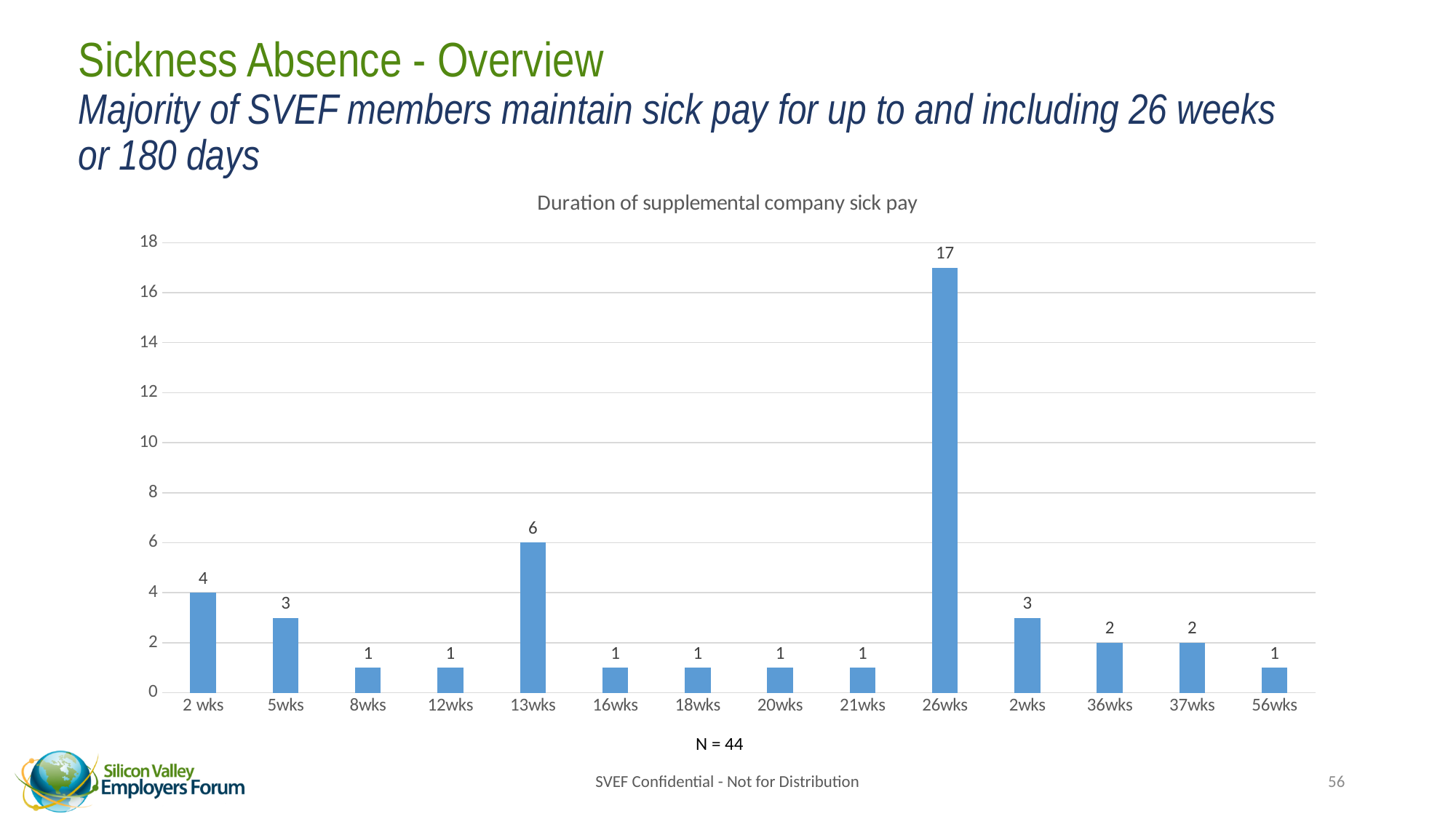
Which category has the highest value? 26wks Which is larger, the value for 13wks or the value for 5wks? 13wks What is the value for 36wks? 2 What kind of chart is this? bar chart What is the difference between the values for 26wks and 13wks? 11 What is the value for 13wks? 6 What is the value for 5wks? 3 What is the value for 26wks? 17 How many categories are shown on the x axis? 14 Is the value for 26wks greater or less than 16? greater What is the value for 56wks? 1 What is the title of the chart? Duration of supplemental company sick pay